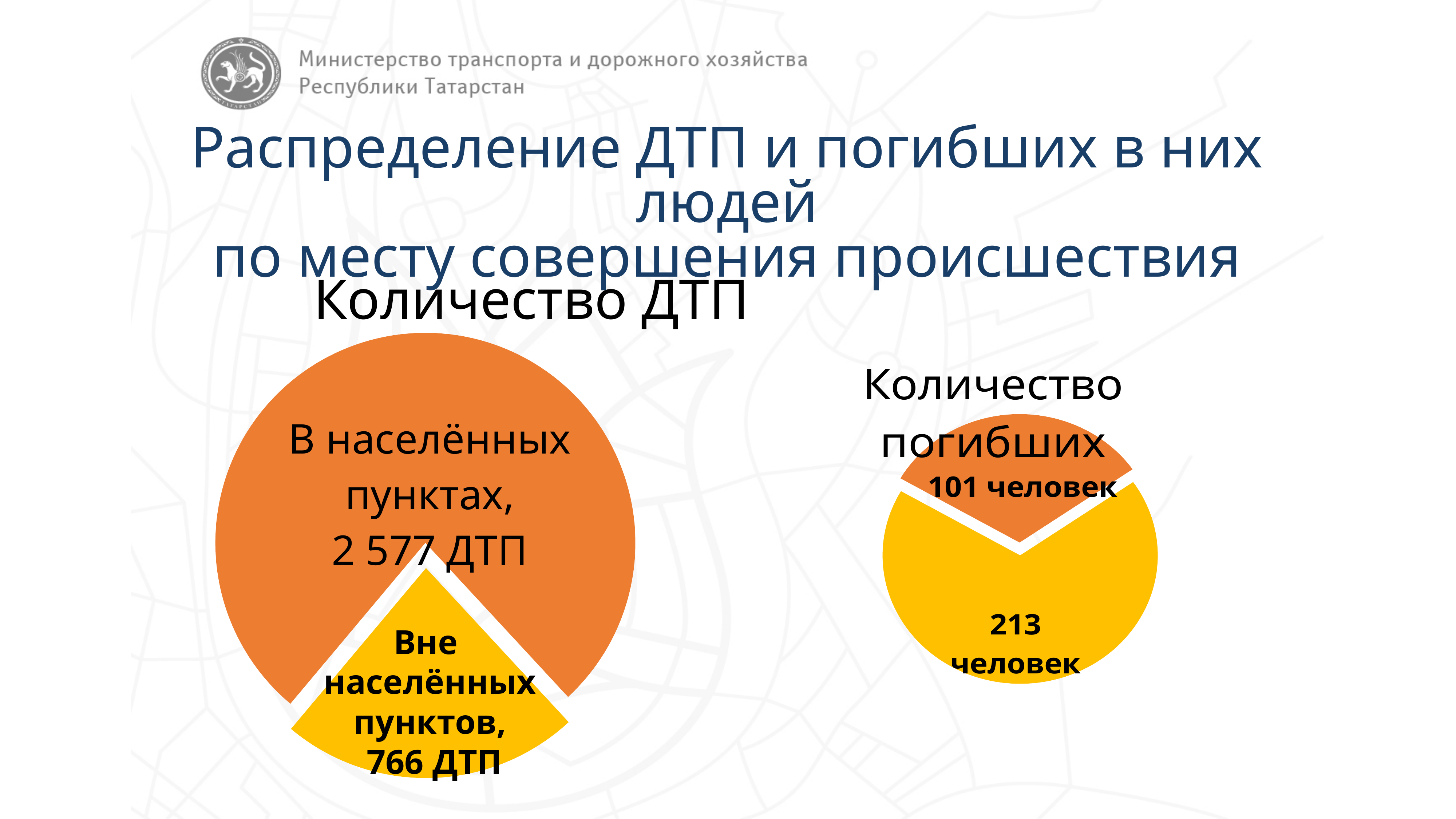
In the "Количество ДТП" chart, which category has the larger slice? В населённых пунктах In the "Количество погибших" chart, what is the value of the orange slice? 101 человек In the "Количество ДТП" chart, what is the total number of accidents across both slices? 3 343 In the "Количество погибших" chart, what is the difference between the two slices? 112 In the "Количество погибших" chart, what is the total of the two slices? 314 In the "Количество ДТП" chart, what is the difference between accidents in populated areas and outside populated areas? 1 811 How many slices does the "Количество ДТП" pie chart have? 2 What kind of chart is the "Количество ДТП" chart? Pie chart In the "Количество ДТП" chart, how many accidents occurred outside populated areas (Вне населённых пунктов)? 766 ДТП In the "Количество погибших" chart, what is the value of the yellow slice? 213 человек In the "Количество ДТП" chart, how many accidents occurred in populated areas (В населённых пунктах)? 2 577 ДТП In the "Количество ДТП" chart, what colour is the slice for "Вне населённых пунктов"? Yellow